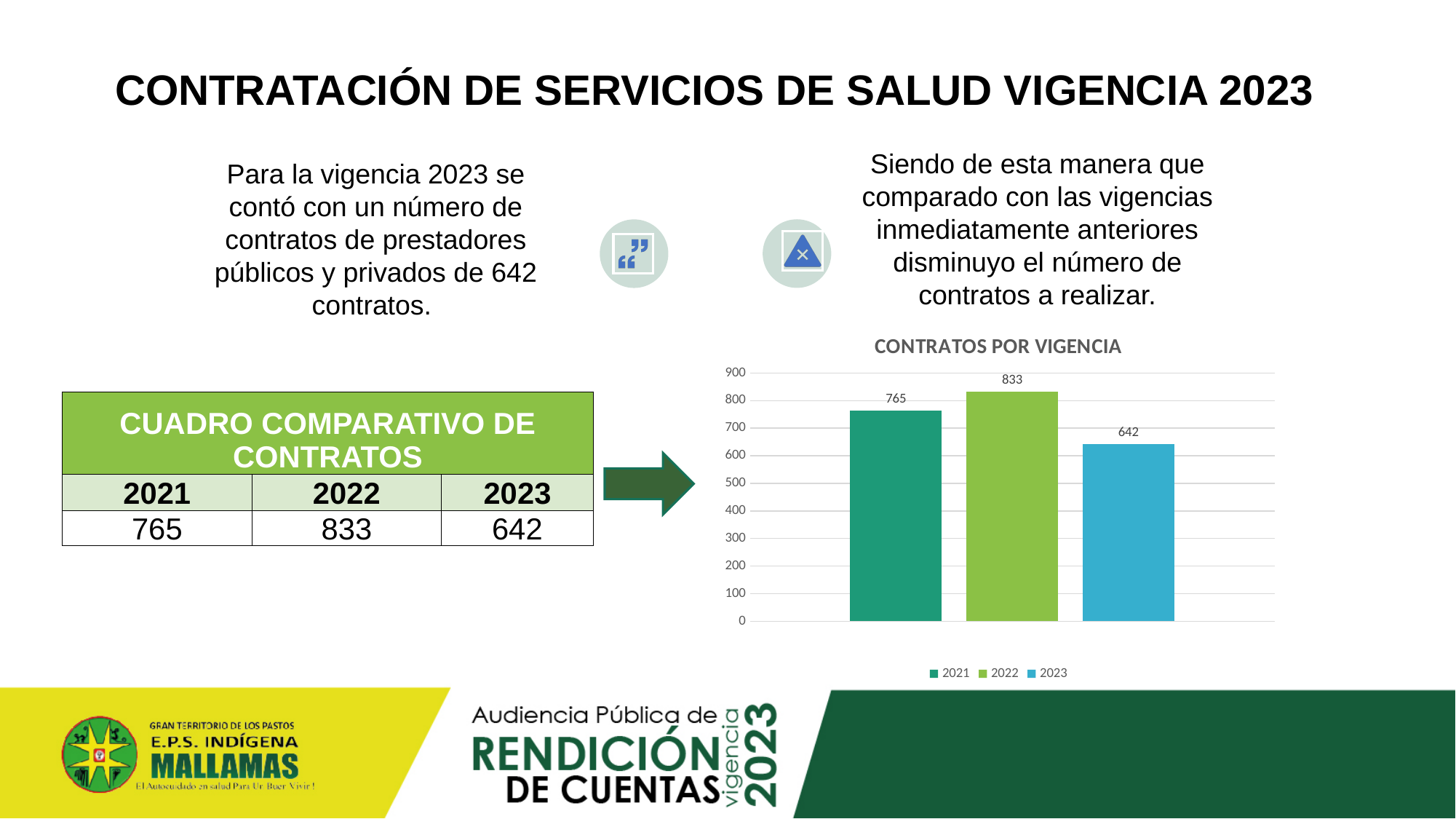
What is the difference between the values for 2022 and 2021? 68 What is the value for 2023 in the chart? 642 What is the value for 2021 in the chart? 765 What is the value for 2022 in the chart? 833 How many bars are shown in the chart? 3 What type of chart is shown on the slide? bar chart What is the difference between the values for 2022 and 2023? 191 Which year has the highest number of contracts in the chart? 2022 Which is larger, the value for 2021 or the value for 2023? 2021 How many entries does the chart legend list? 3 What is the title of the chart? CONTRATOS POR VIGENCIA Which year has the lowest number of contracts in the chart? 2023